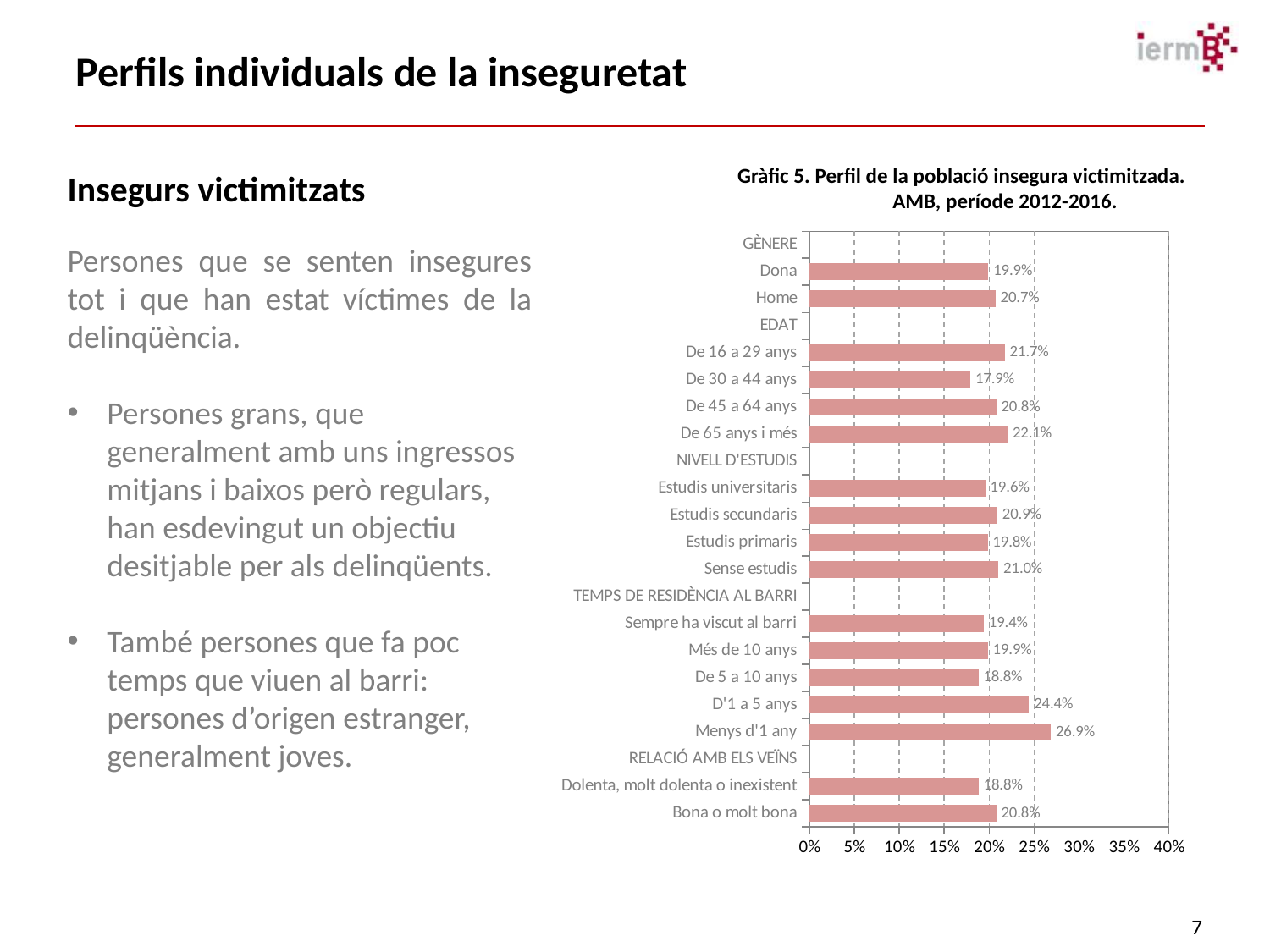
What is the value for "De 30 a 44 anys"? 17.9% Which category has the lowest value in the chart? De 30 a 44 anys What is the value for "Dona"? 19.9% What is the value for "Sense estudis"? 21.0% What is the value for "Menys d'1 any"? 26.9% What is the difference between the values for "Home" and "Dona"? 0.8% What kind of chart is shown on the slide? Bar chart Which is larger, the value for "De 65 anys i més" or the value for "De 16 a 29 anys"? De 65 anys i més Which category has the highest value in the chart? Menys d'1 any Is the value for "D'1 a 5 anys" greater or less than 20%? greater How many bars are plotted in the chart? 17 What is the difference between the values for "Menys d'1 any" and "D'1 a 5 anys"? 2.5%